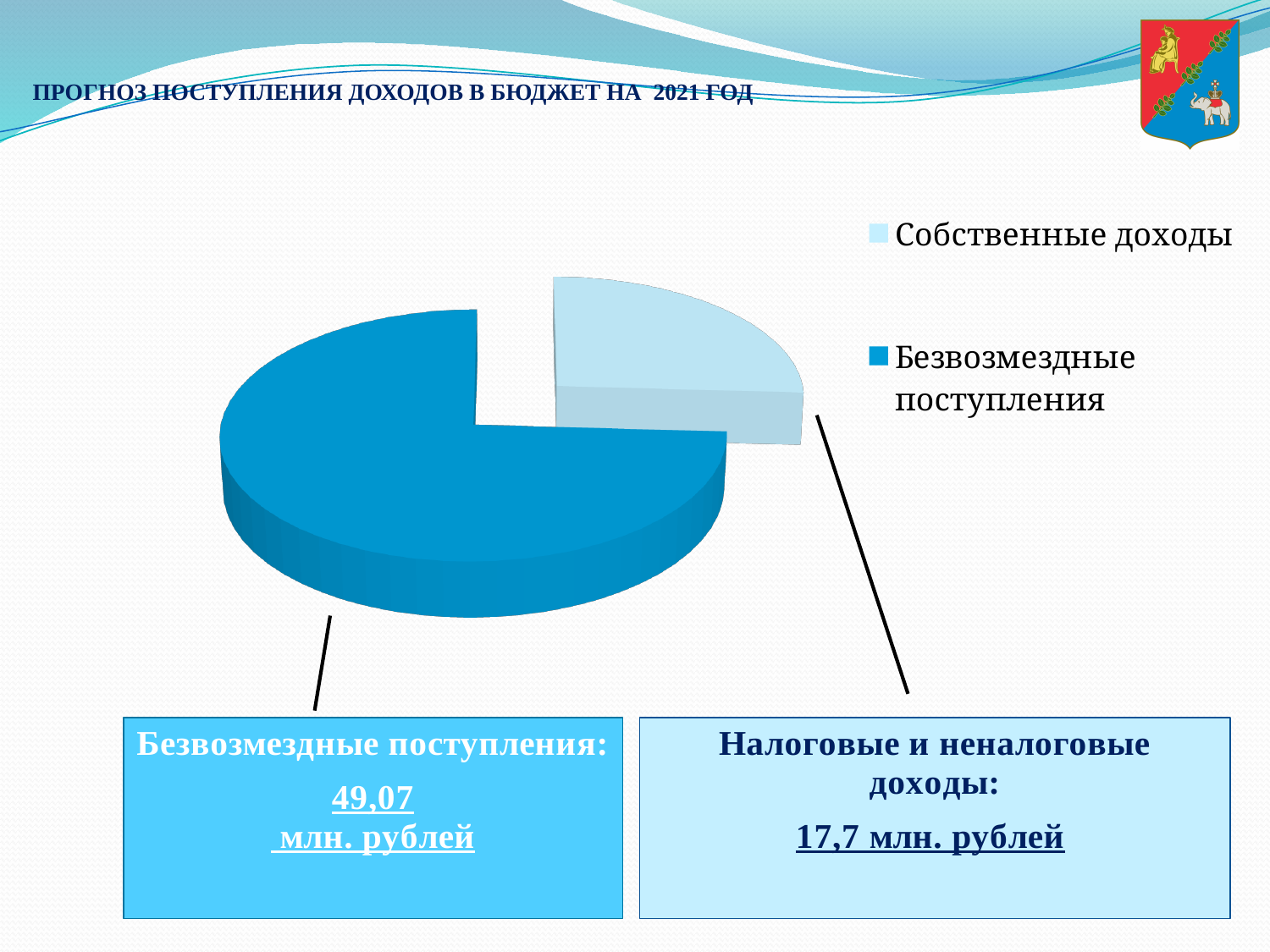
How many slices does the pie chart have? 2 What value is given for Безвозмездные поступления? 49,07 млн. рублей Which legend entry is shown in the lighter blue colour? Собственные доходы How many entries does the legend of the pie chart list? 2 Which is larger: Безвозмездные поступления or Налоговые и неналоговые доходы? Безвозмездные поступления Which slice of the pie chart is the largest? Безвозмездные поступления Which slice of the pie chart is the smallest? Собственные доходы What is the title of the slide containing the pie chart? ПРОГНОЗ ПОСТУПЛЕНИЯ ДОХОДОВ В БЮДЖЕТ НА 2021 ГОД What is the total of the two values shown in the boxes below the pie chart? 66,77 млн. рублей What kind of chart is shown on the slide? pie chart What value is given for Налоговые и неналоговые доходы? 17,7 млн. рублей By how much do Безвозмездные поступления (49,07 млн. рублей) exceed Налоговые и неналоговые доходы (17,7 млн. рублей)? 31,37 млн. рублей